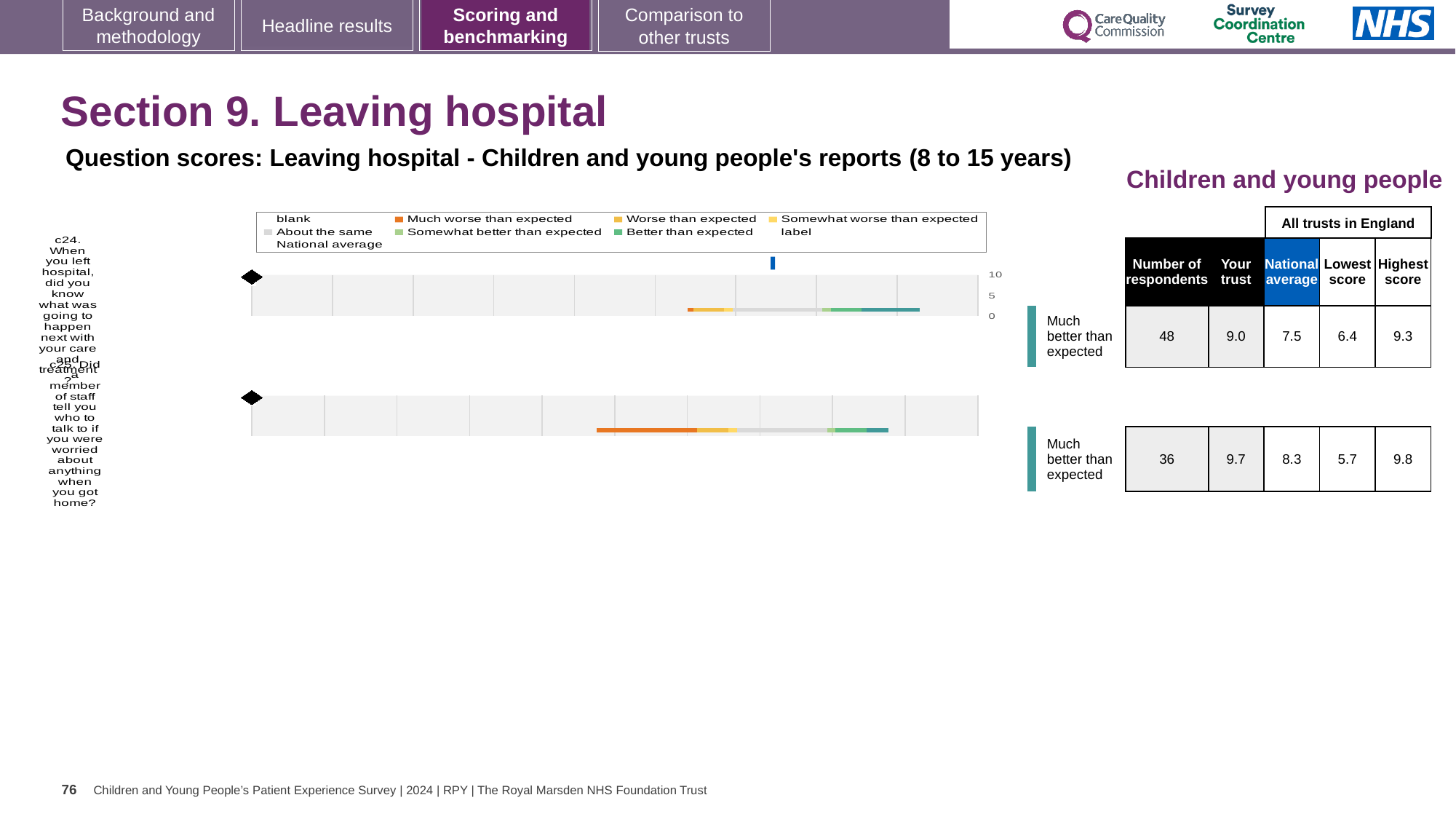
What is the lowest score among all trusts in England for question c24? 6.4 What kind of chart is used to show the question scores for c24 and c25? bar chart What is the highest score among all trusts in England for question c25? 9.8 According to the table beside the chart, what is the national average score for question c25? 8.3 In the chart legend, what colour represents 'Much worse than expected'? orange Which question has the higher 'Your trust' score, c24 or c25? c25 What is the maximum value shown on the chart's score axis? 10 According to the table beside the chart, what is the 'Your trust' score for question c24? 9.0 How many respondents answered question c24, according to the table? 48 What benchmark rating is shown next to both c24 and c25? Much better than expected What is the difference between the 'Your trust' score and the national average for question c24? 1.5 How many survey questions (bars) are plotted in the chart? 2